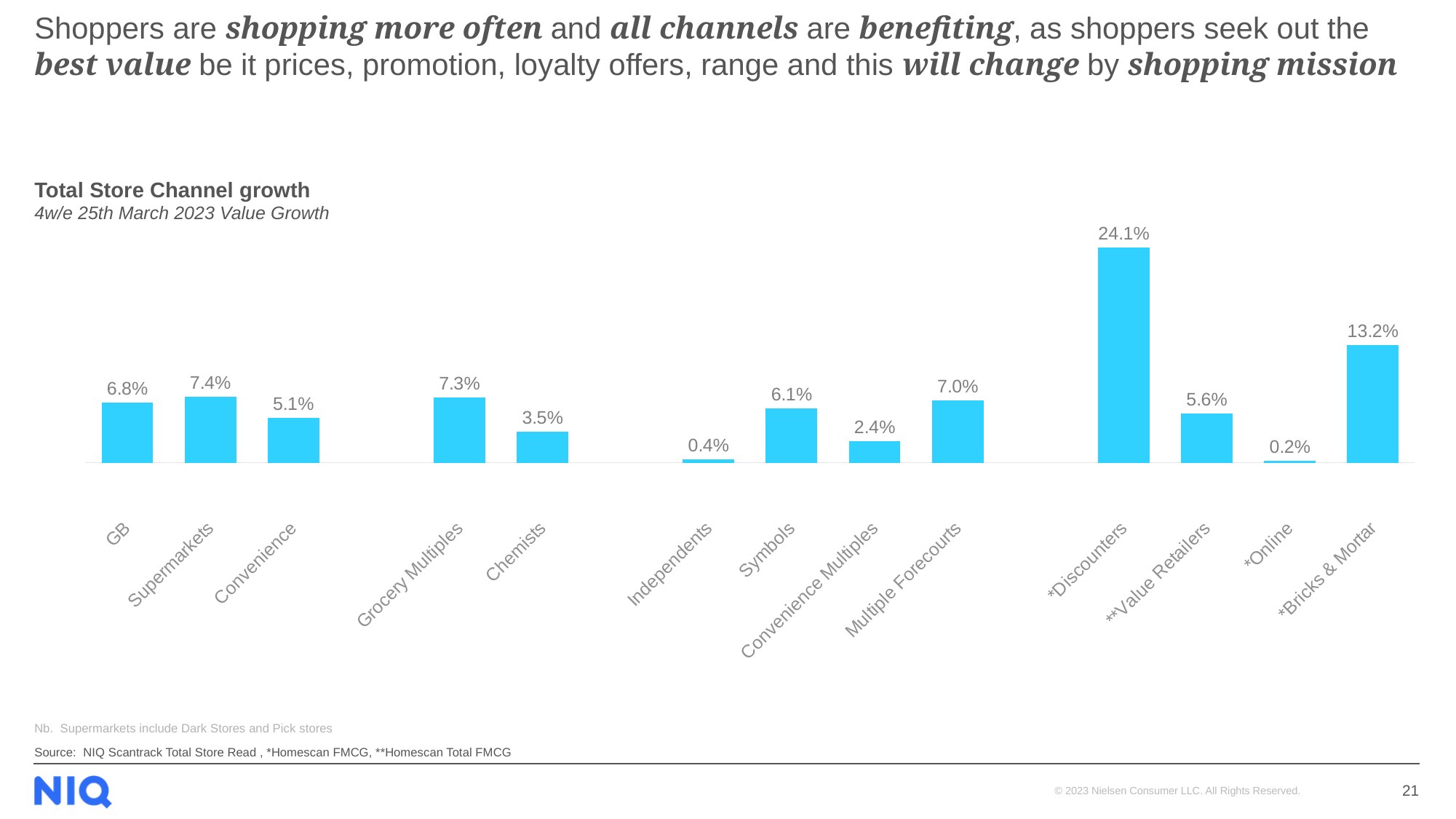
How many channels are shown in the chart? 14 What is the difference between the value growth for Supermarkets and Convenience? 2.3% What is the difference between the value growth for *Discounters and *Bricks & Mortar? 10.9% Which channel has the lowest value growth? *Online What kind of chart is shown on the slide? Bar chart Which channel has the highest value growth? *Discounters Which has higher value growth, Symbols or Multiple Forecourts? Multiple Forecourts What is the title of the chart? Total Store Channel growth What is the value growth for *Bricks & Mortar? 13.2% What is the value growth for Independents? 0.4% What is the value growth for Supermarkets? 7.4% What is the value growth for *Discounters? 24.1%